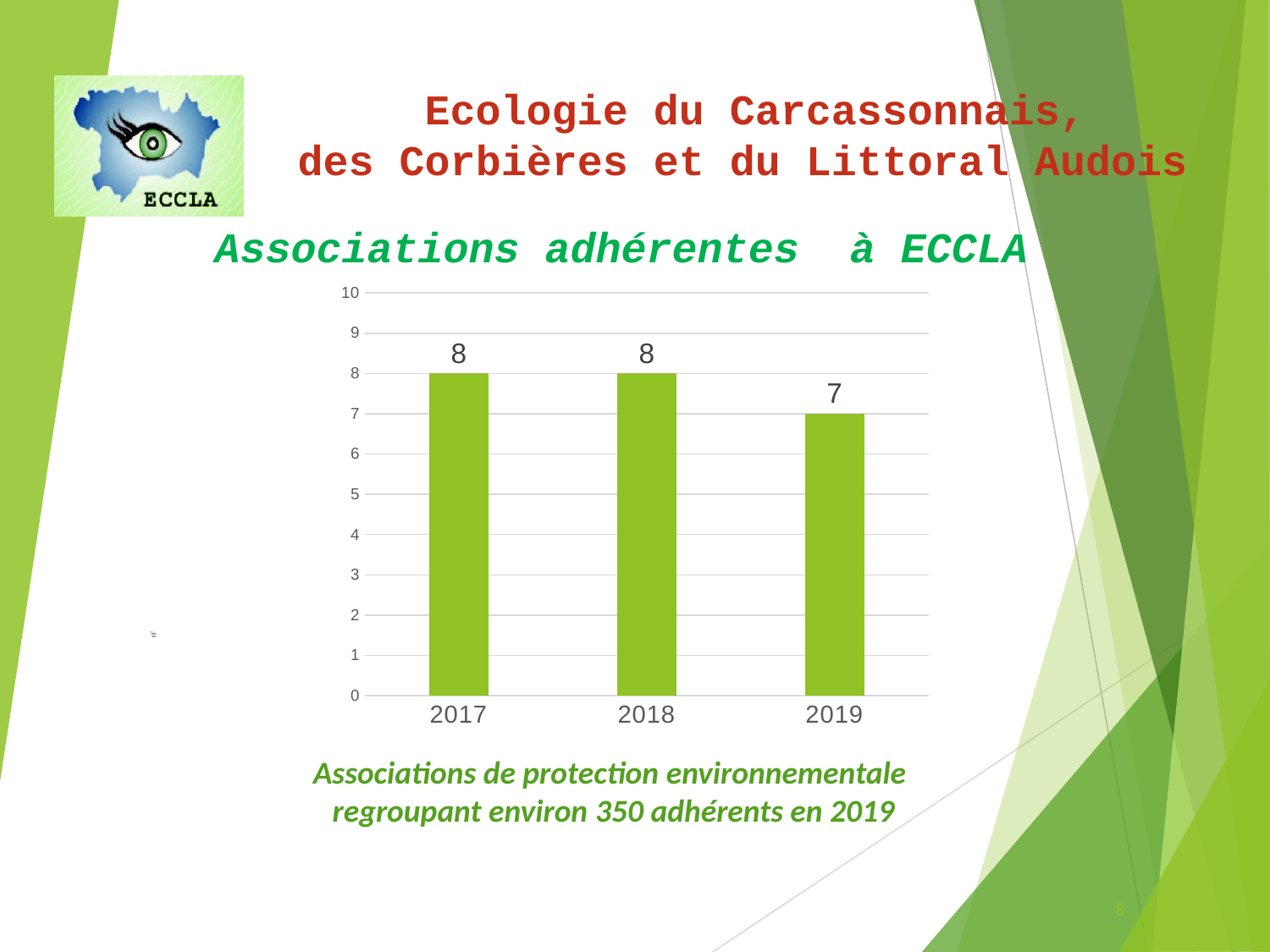
What is the title of the chart? Associations adhérentes à ECCLA What is the value for 2019? 7 What kind of chart is shown on the slide? bar chart What is the value for 2018? 8 Which year has the lowest value? 2019 Which is larger, the value for 2017 or the value for 2019? 2017 What is the difference between the values for 2018 and 2019? 1 What is the maximum value shown on the y axis? 10 What is the value for 2017? 8 How many years are shown on the x axis? 3 Is the value for 2019 greater or less than 5? greater Do the values rise or fall from 2018 to 2019? fall